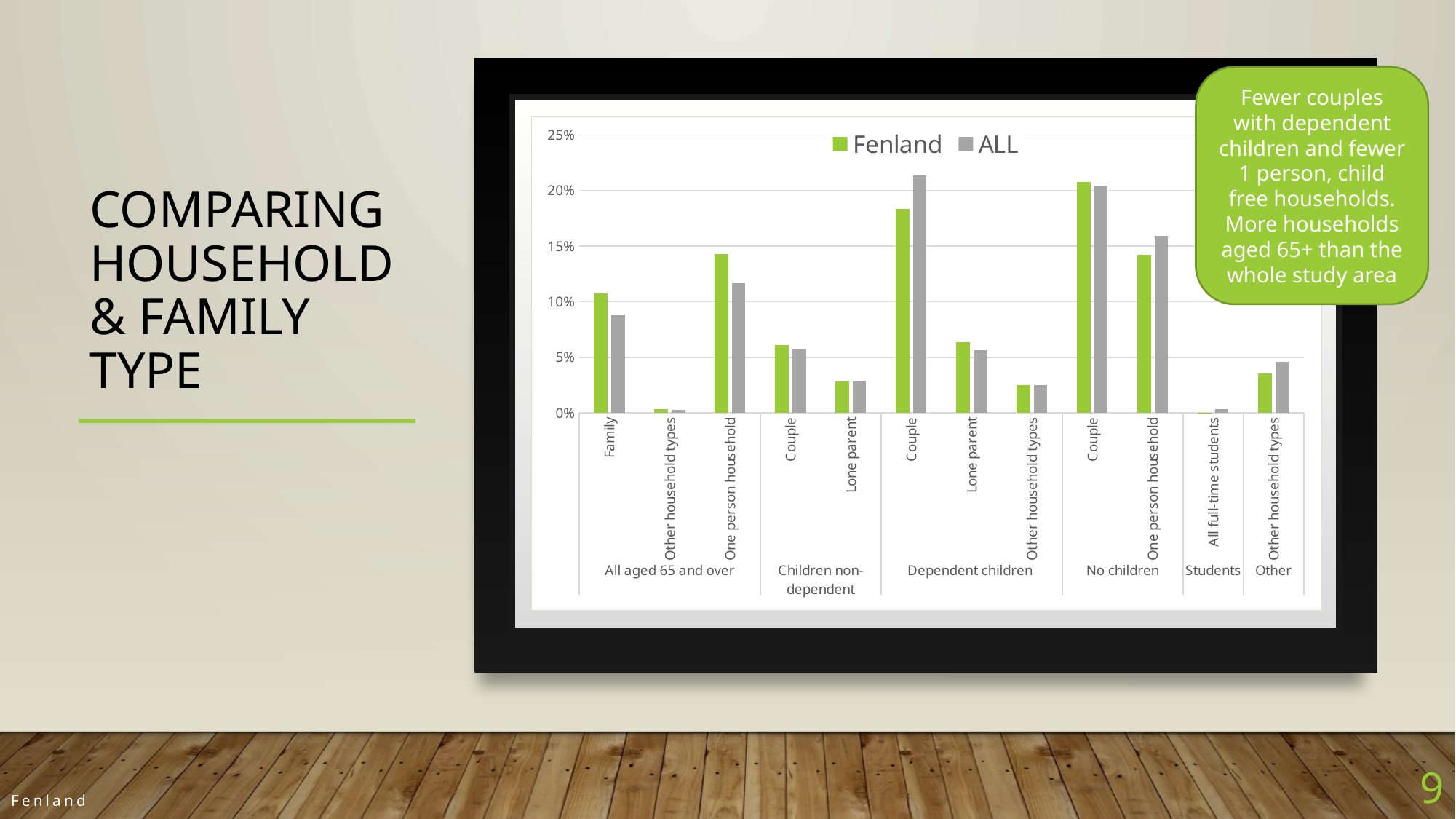
How many household categories are plotted along the x axis? 12 Is the Fenland value for Couple under Dependent children greater or less than 15%? greater Is the Fenland value for One person household under All aged 65 and over greater or less than 10%? greater For Family under All aged 65 and over, which series is larger, Fenland or ALL? Fenland What kind of chart is shown on the slide? bar chart For One person household under No children, which series is larger, Fenland or ALL? ALL For Couple under Dependent children, which series is larger, Fenland or ALL? ALL Which category has the highest Fenland value? Couple (No children) Which two series are shown in the legend? Fenland and ALL Is the ALL value for Couple under Dependent children greater or less than 20%? greater How many series does the legend list? 2